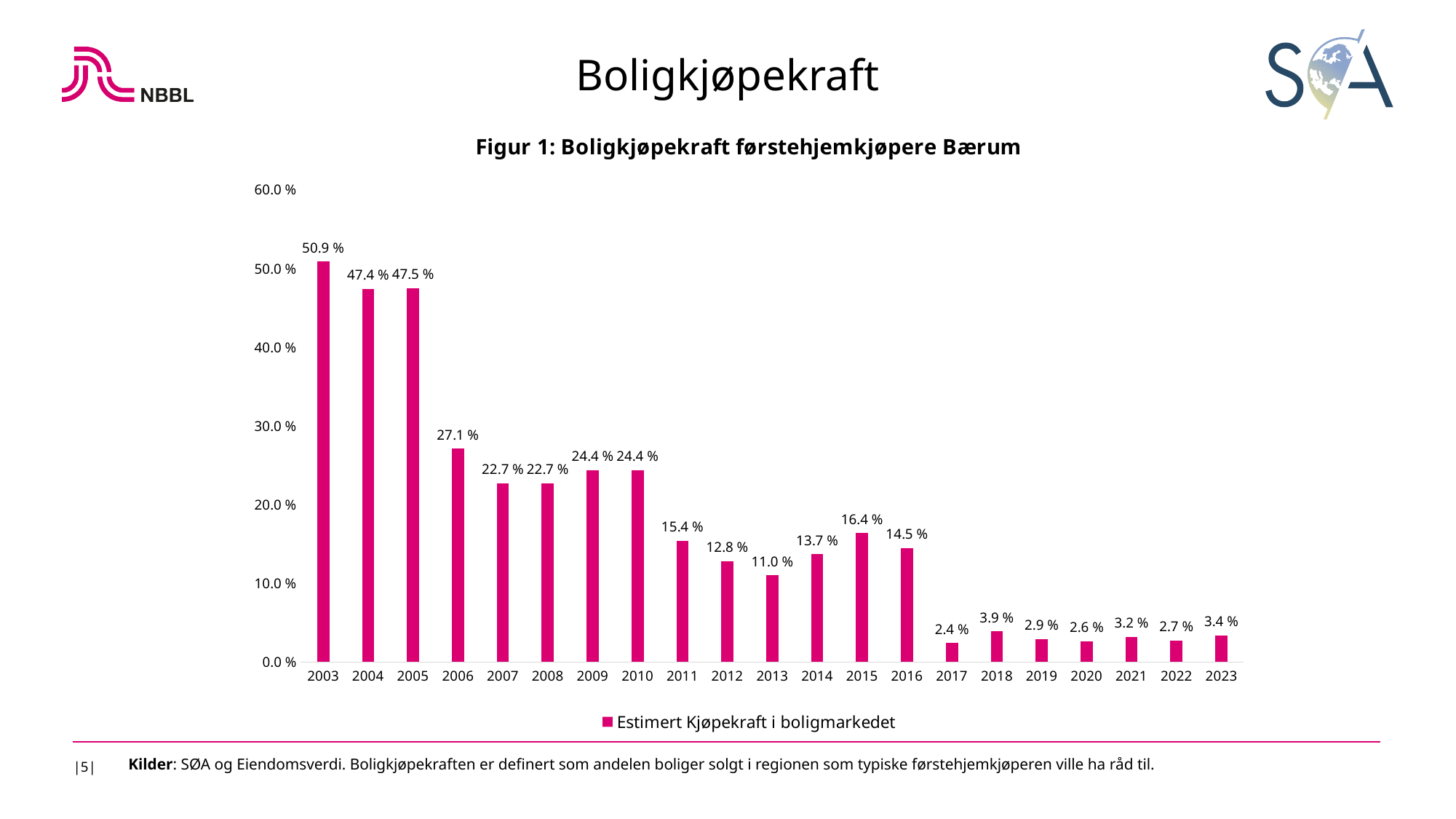
Which year has the lowest value? 2017 What is the difference between the values for 2005 and 2006? 20.4 % What is the value for 2015? 16.4 % What is the legend entry for the series? Estimert Kjøpekraft i boligmarkedet What is the value for 2023? 3.4 % What is the value for 2003? 50.9 % Is the value for 2009 greater or less than 20.0 %? greater Which year has the highest value? 2003 Which is larger, the value for 2011 or the value for 2012? 2011 What kind of chart is shown? bar chart How many series does the legend list? 1 How many years are shown on the x axis? 21